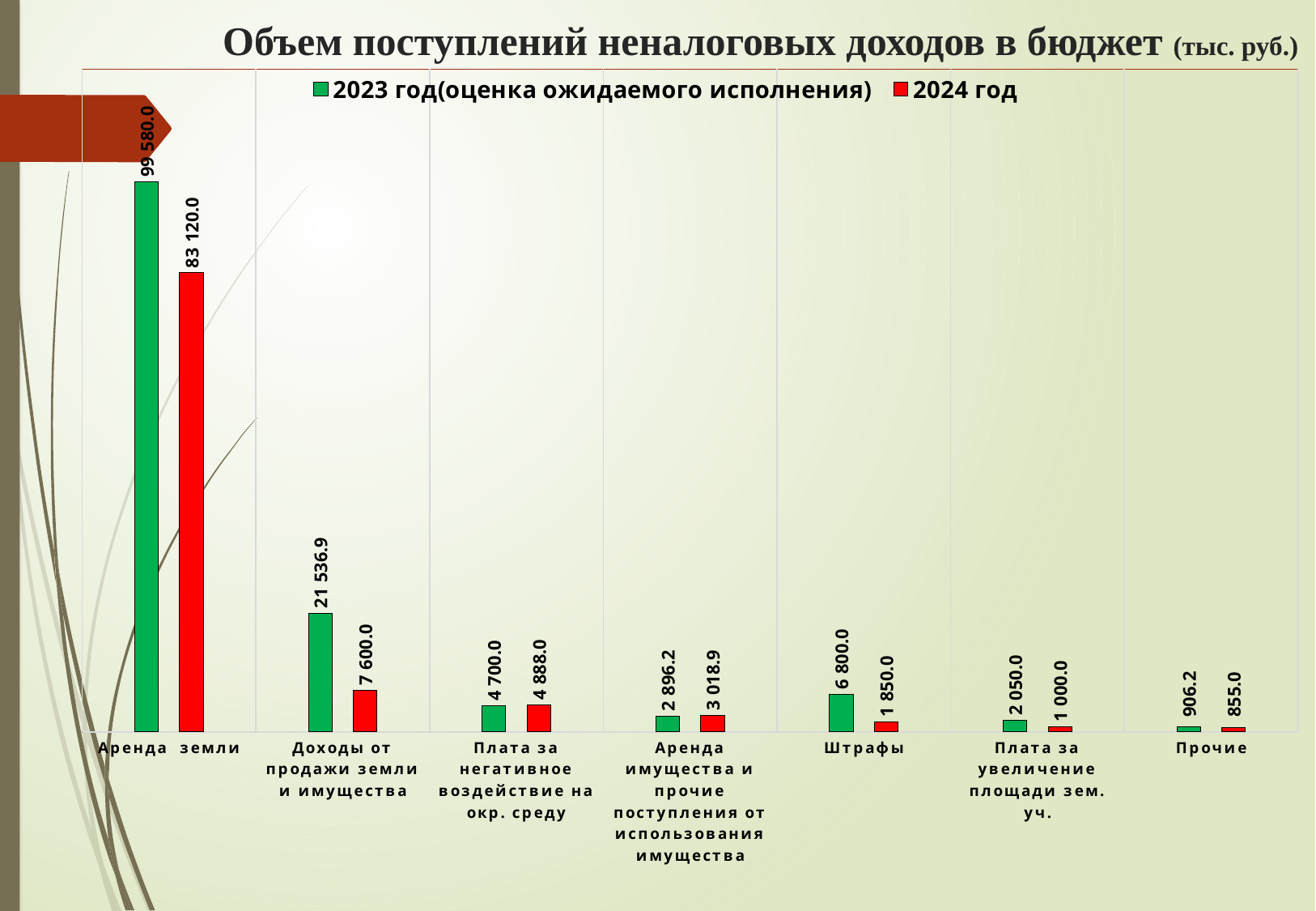
What kind of chart is shown on the slide? Bar chart For Аренда имущества и прочие поступления от использования имущества, which is larger: the 2023 год value or the 2024 год value? 2024 год What is the difference between the 2023 год and 2024 год values for Доходы от продажи земли и имущества? 13 936.9 How many series does the legend list? 2 How many categories are shown on the x axis? 7 Which category has the lowest 2024 год value? Прочие What is the 2024 год value for Аренда земли? 83 120.0 What is the difference between the 2023 год and 2024 год values for Штрафы? 4 950.0 Which category has the highest 2023 год (оценка ожидаемого исполнения) value? Аренда земли What unit is given in the chart title? тыс. руб. What is the 2023 год (оценка ожидаемого исполнения) value for Штрафы? 6 800.0 What is the 2024 год value for Плата за негативное воздействие на окр. среду? 4 888.0